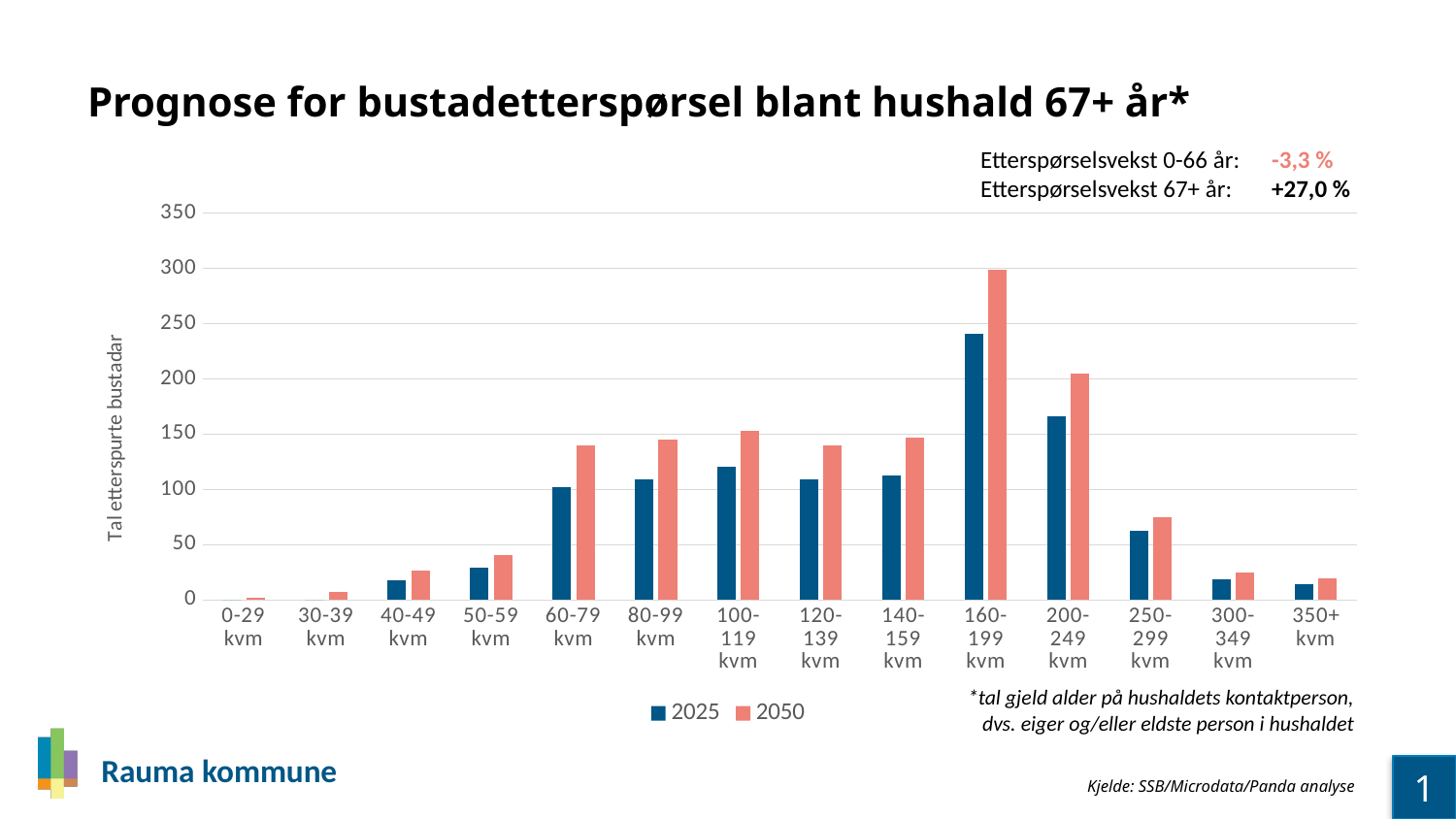
Which size category has the highest value for 2025? 160-199 kvm Is the 2050 value for 160-199 kvm greater or less than 250? greater For 160-199 kvm, which series has the larger value, 2025 or 2050? 2050 Which size category has the lowest value for 2050? 0-29 kvm How many series does the legend list? 2 How many size categories are shown on the x axis? 14 Is the 2025 value for 200-249 kvm greater or less than 150? greater Is the 2025 value for 160-199 kvm greater or less than 250? less What is the title of the chart? Prognose for bustadetterspørsel blant hushald 67+ år* What kind of chart is shown on the slide? bar chart Which size category has the highest value for 2050? 160-199 kvm